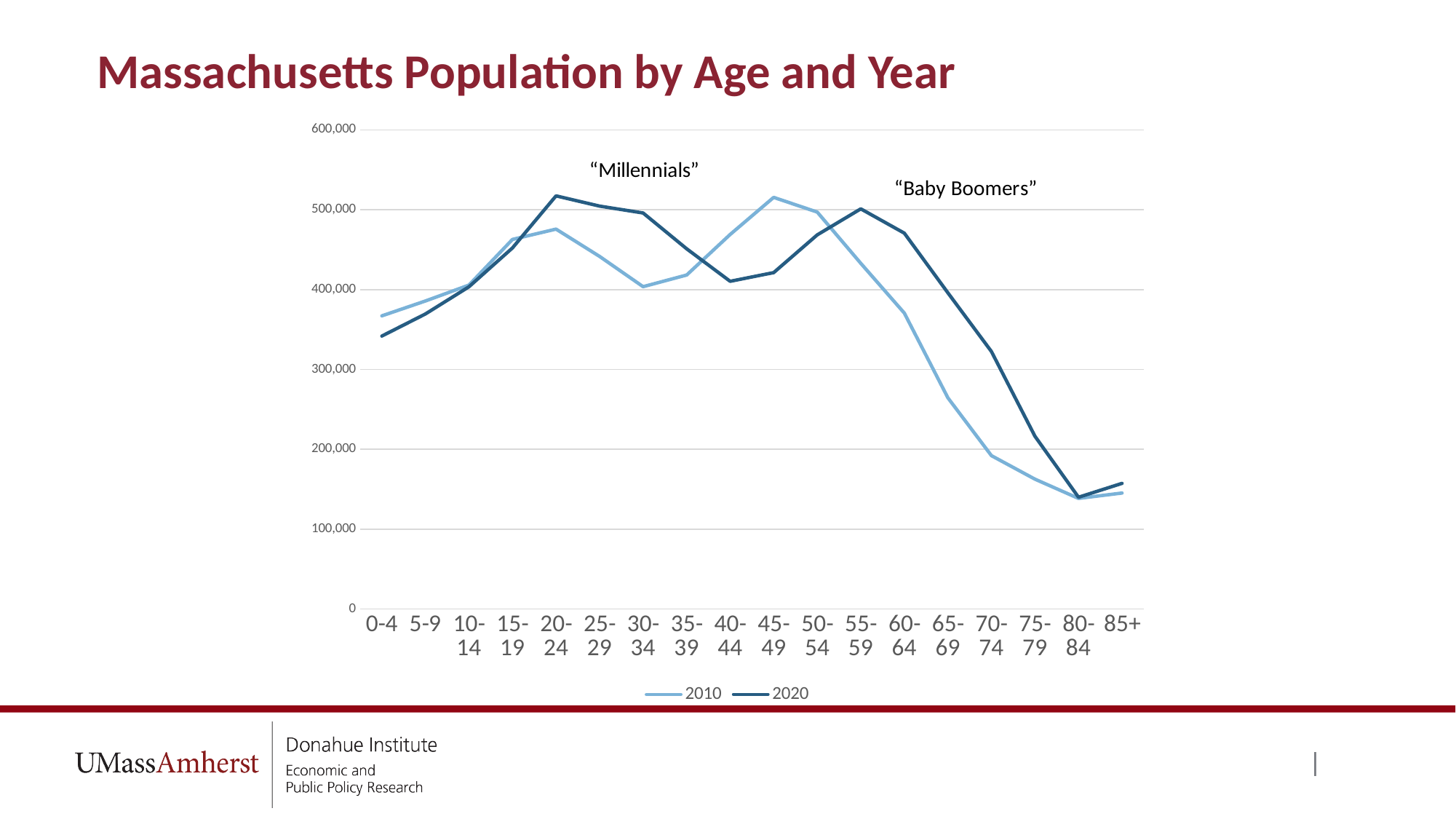
Which age group has the highest 2010 population? 45-49 Which age group has the lowest 2020 population? 80-84 For the 45-49 age group, which series has the larger value, 2010 or 2020? 2010 Is the 2010 value for the 45-49 age group greater or less than 500,000? greater How many age groups are shown on the x axis? 18 How many series does the legend list? 2 For the 20-24 age group, which series has the larger value, 2010 or 2020? 2020 Is the 2010 value for the 65-69 age group greater or less than 300,000? less Do the 2020 values rise or fall from the 55-59 age group to the 80-84 age group? Fall Which age group has the highest 2020 population? 20-24 What kind of chart is shown on the slide? Line chart Is the 2020 value for the 0-4 age group greater or less than 400,000? less